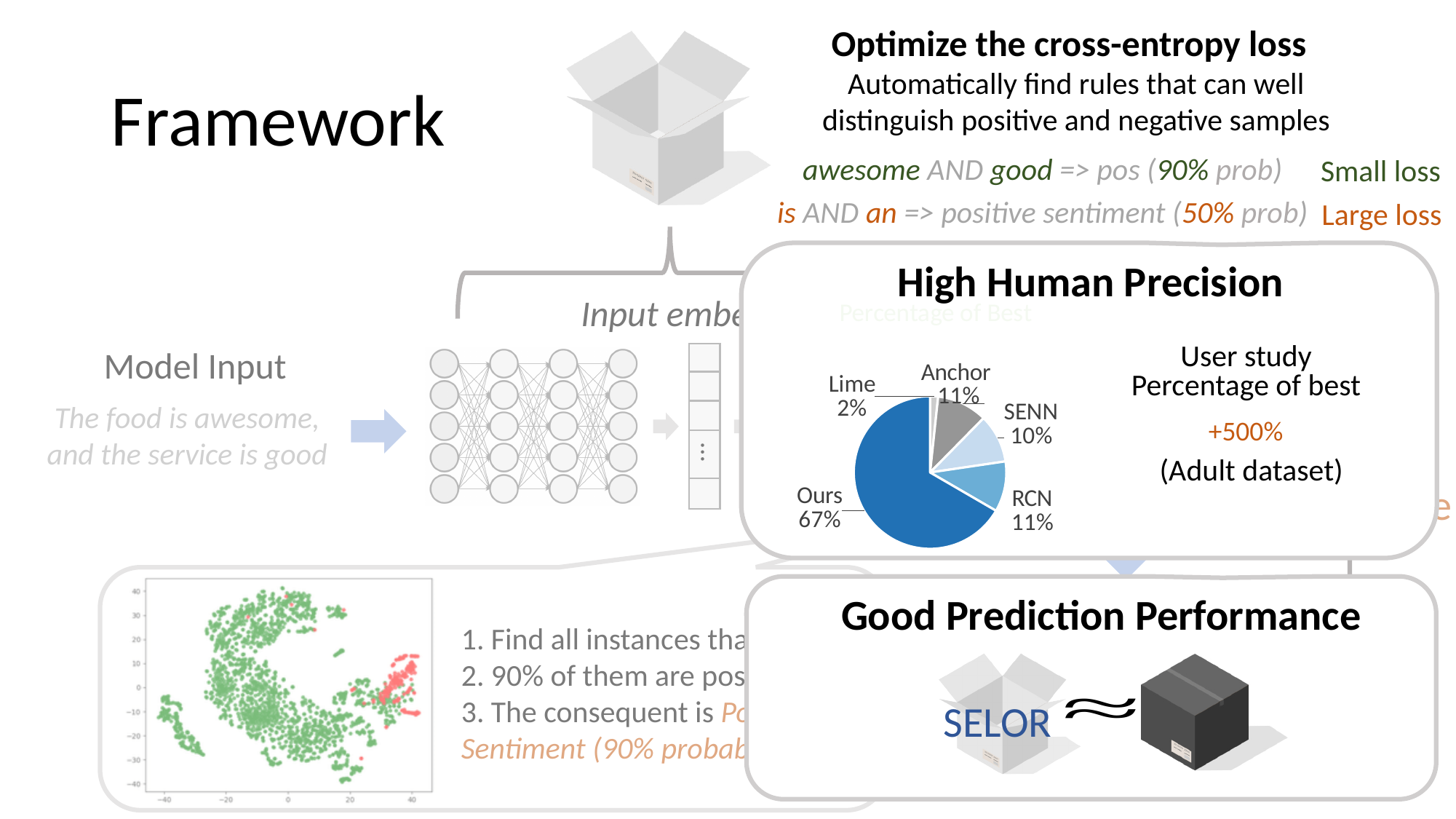
According to the text next to the pie chart under "High Human Precision", which dataset does the user study use? Adult dataset In the pie chart under "High Human Precision", what percentage is shown for Ours? 67% In the pie chart under "High Human Precision", what percentage is shown for Anchor? 11% In the pie chart under "High Human Precision", which is larger, the slice for SENN or the slice for Lime? SENN In the pie chart under "High Human Precision", which method has the largest slice? Ours In the pie chart under "High Human Precision", which method has the smallest slice? Lime In the pie chart under "High Human Precision", what is the difference in percentage points between Ours and SENN? 57 In the pie chart under "High Human Precision", what percentage is shown for Lime? 2% In the pie chart under "High Human Precision", what percentage is shown for RCN? 11% In the pie chart under "High Human Precision", what percentage is shown for SENN? 10% What kind of chart is shown under "High Human Precision"? Pie chart How many slices does the pie chart under "High Human Precision" have? 5